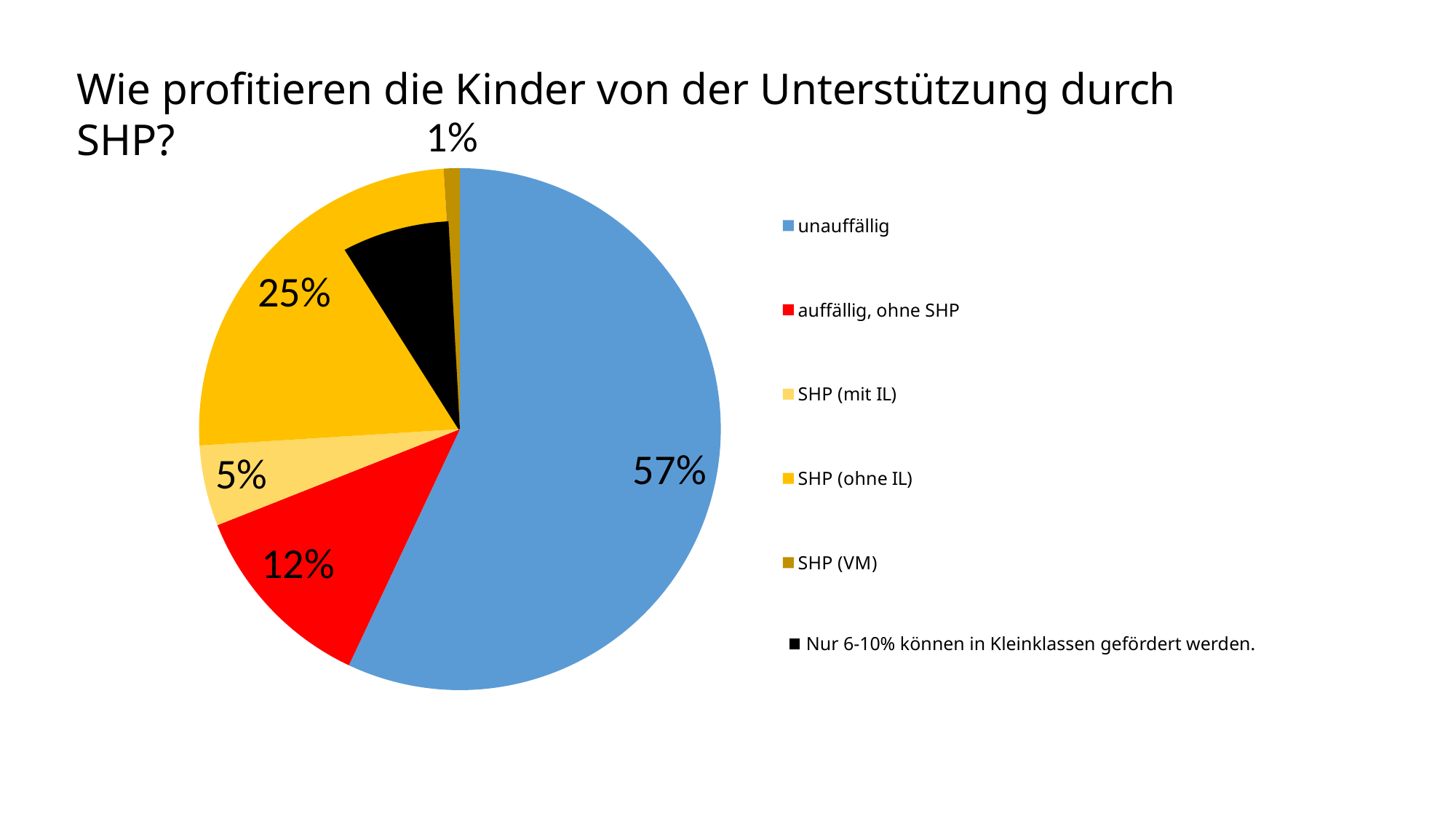
How many entries does the legend list? 6 Which category has the largest share of the pie? unauffällig What percentage is shown for the 'SHP (mit IL)' slice? 5% What percentage is shown for the 'SHP (VM)' slice? 1% What percentage is shown for the 'auffällig, ohne SHP' slice? 12% What kind of chart is shown on the slide? pie chart What percentage is shown for the 'SHP (ohne IL)' slice? 25% What is the difference in percentage points between 'unauffällig' and 'SHP (ohne IL)'? 32 What percentage is shown for the 'unauffällig' slice? 57% What colour is the 'unauffällig' slice? blue Which is larger, the share for 'auffällig, ohne SHP' or the share for 'SHP (mit IL)'? auffällig, ohne SHP Which labelled category has the smallest share of the pie? SHP (VM)